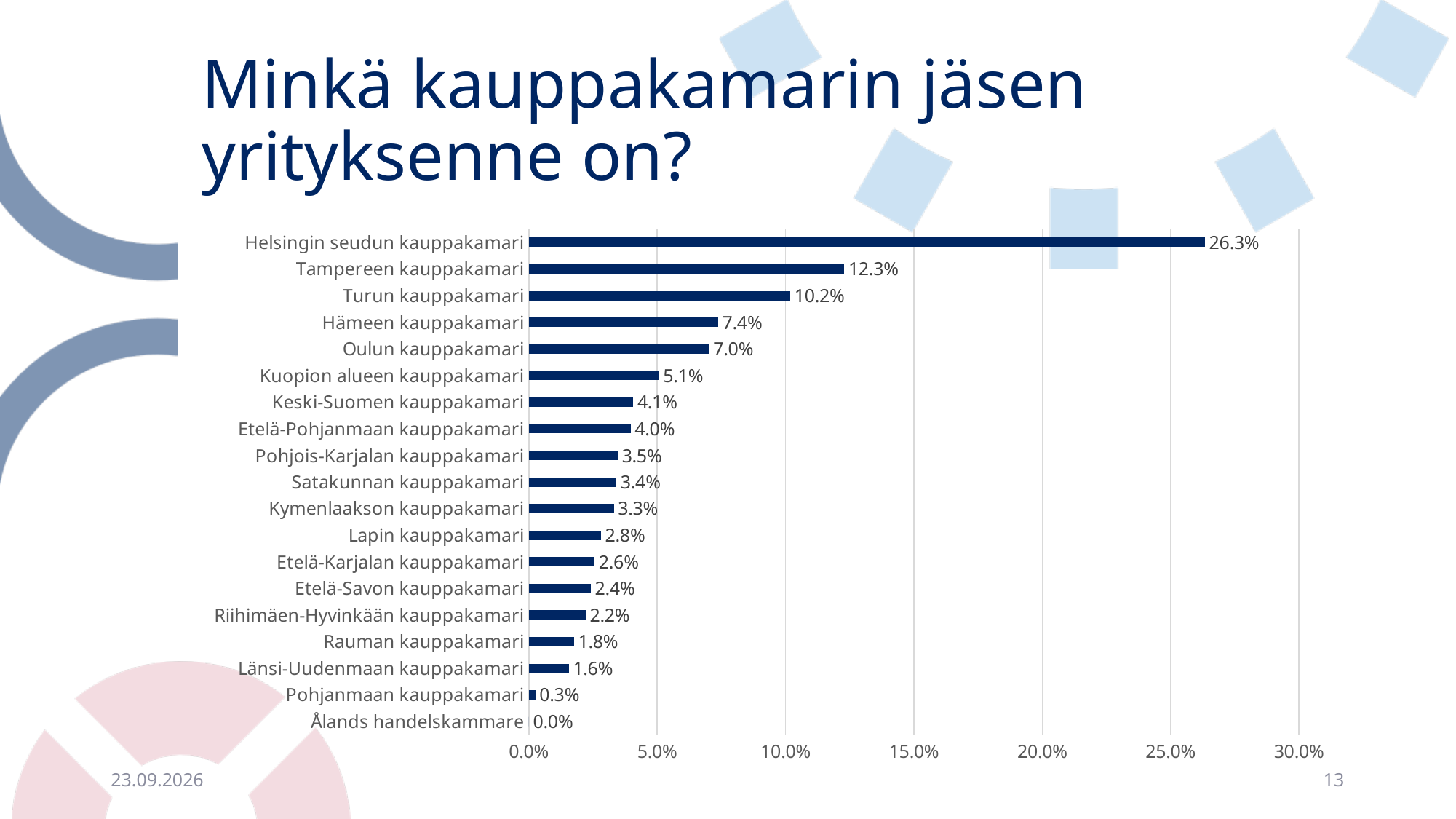
What is the value for Riihimäen-Hyvinkään kauppakamari? 2.2% What kind of chart is shown on the slide? Bar chart How many categories are shown in the chart? 19 Is the value for Turun kauppakamari greater or less than 10.0%? greater What is the value for Kuopion alueen kauppakamari? 5.1% Which category has the lowest value? Ålands handelskammare What is the value for Tampereen kauppakamari? 12.3% What is the difference between the values for Turun kauppakamari and Hämeen kauppakamari? 2.8% Which category has the highest value? Helsingin seudun kauppakamari What is the difference between the values for Helsingin seudun kauppakamari and Tampereen kauppakamari? 14.0% Which is larger, the value for Oulun kauppakamari or the value for Lapin kauppakamari? Oulun kauppakamari What is the title of the slide? Minkä kauppakamarin jäsen yrityksenne on?